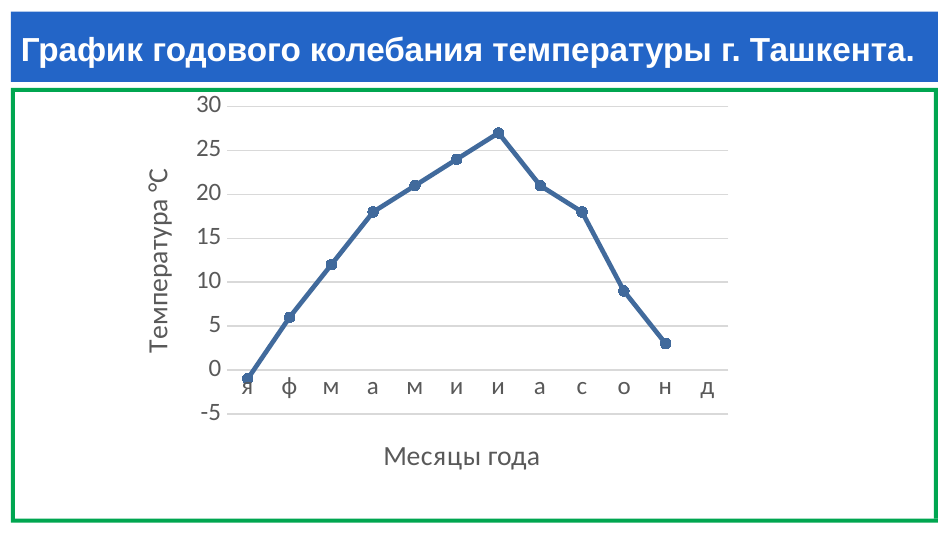
What kind of chart is shown on the slide? line chart Which month label on the x axis has the lowest temperature? я Which is higher: the temperature for the third month (м) or for the month labelled о? the third month (м) What is the label of the vertical axis? Температура °C What is the title of the chart? График годового колебания температуры г. Ташкента. Is the temperature for the month labelled о greater or less than 10? less Is the highest point of the line greater or less than 25? greater Is the temperature for the month labelled н greater or less than 5? less How does the temperature change along the x axis from the first month to the seventh month? it rises At which month label (counting from the left) does the line reach its highest point? the seventh label (и)